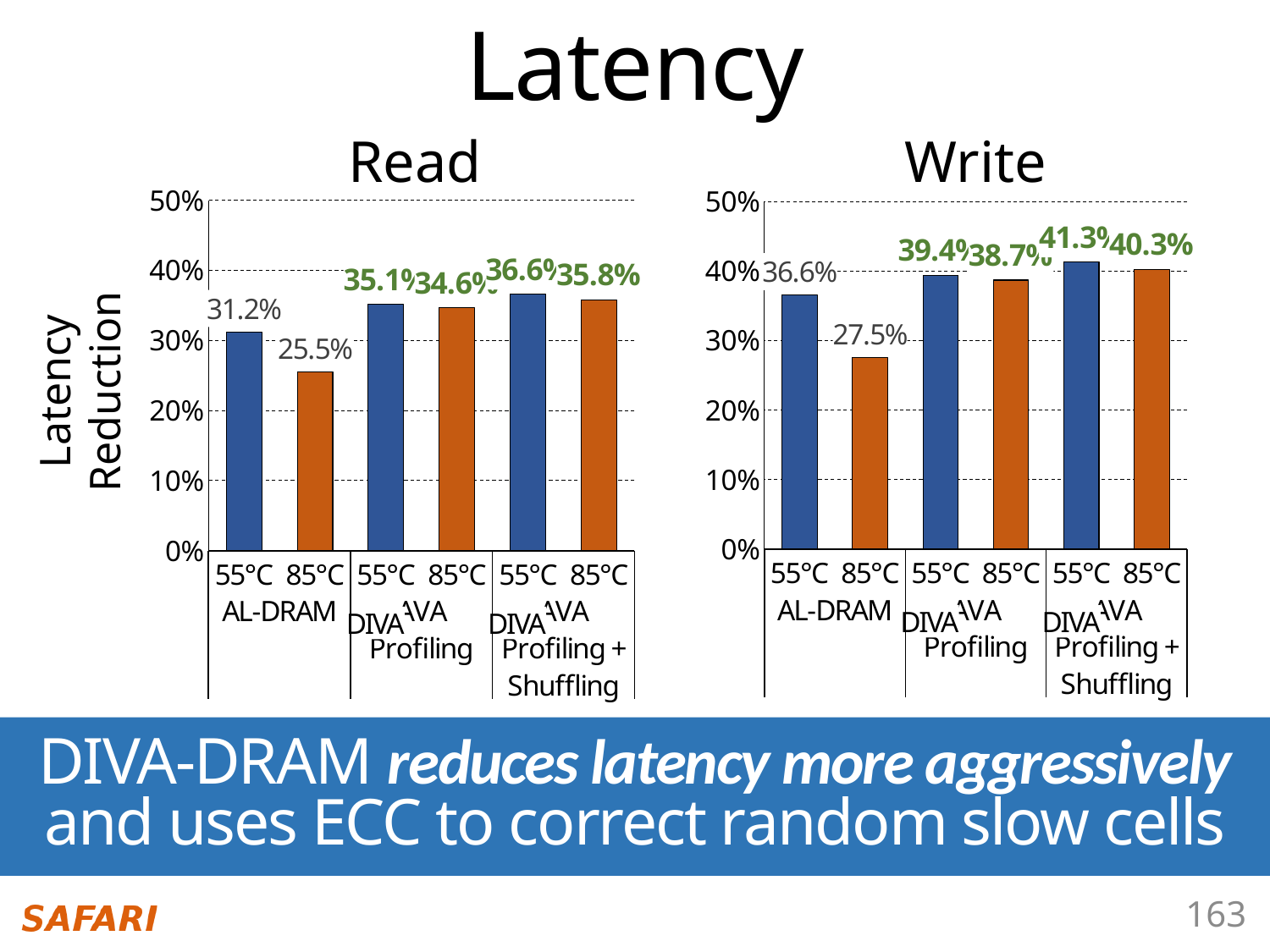
In the Read chart, what is the difference between the AL-DRAM 55°C and 85°C latency reductions? 5.7% In the Write chart, what is the difference between the DIVA Profiling + Shuffling 55°C and 85°C latency reductions? 1.0% What kind of chart is the Read chart? bar chart In the Read chart, which bar has the highest latency reduction? DIVA Profiling + Shuffling at 55°C In the Write chart, which is larger: the latency reduction for AL-DRAM at 55°C or for DIVA Profiling at 85°C? DIVA Profiling at 85°C In the Write chart, what is the latency reduction for DIVA Profiling + Shuffling at 55°C? 41.3% In the Read chart, what is the latency reduction for AL-DRAM at 85°C? 25.5% In the Write chart, what is the latency reduction for AL-DRAM at 85°C? 27.5% How many bars are plotted in the Write chart? 6 In the Read chart, is the latency reduction for AL-DRAM at 85°C greater or less than 30%? less In the Write chart, which bar has the lowest latency reduction? AL-DRAM at 85°C In the Read chart, what is the latency reduction for AL-DRAM at 55°C? 31.2%